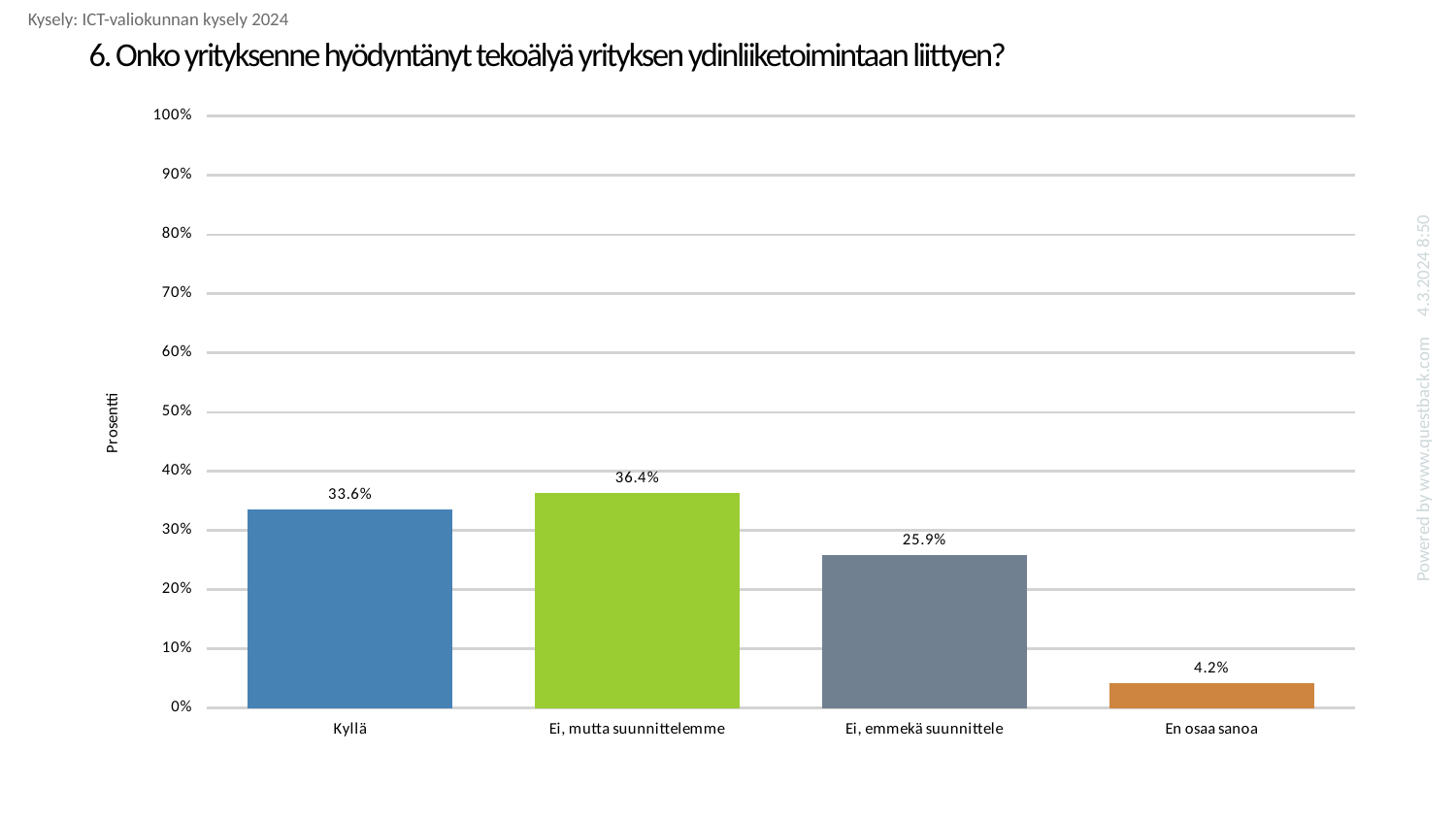
What is the value for "Ei, emmekä suunnittele"? 25.9% What kind of chart is shown on the slide? bar chart What is the value for "Kyllä"? 33.6% Which is larger, the value for "Kyllä" or the value for "Ei, emmekä suunnittele"? Kyllä What is the difference between the values for "Ei, mutta suunnittelemme" and "Kyllä"? 2.8% What is the label of the y axis? Prosentti Which category has the lowest value? En osaa sanoa How many categories are shown on the x axis? 4 What is the value for "En osaa sanoa"? 4.2% Which category has the highest value? Ei, mutta suunnittelemme What is the value for "Ei, mutta suunnittelemme"? 36.4% Is the value for "Ei, emmekä suunnittele" greater or less than 30%? less